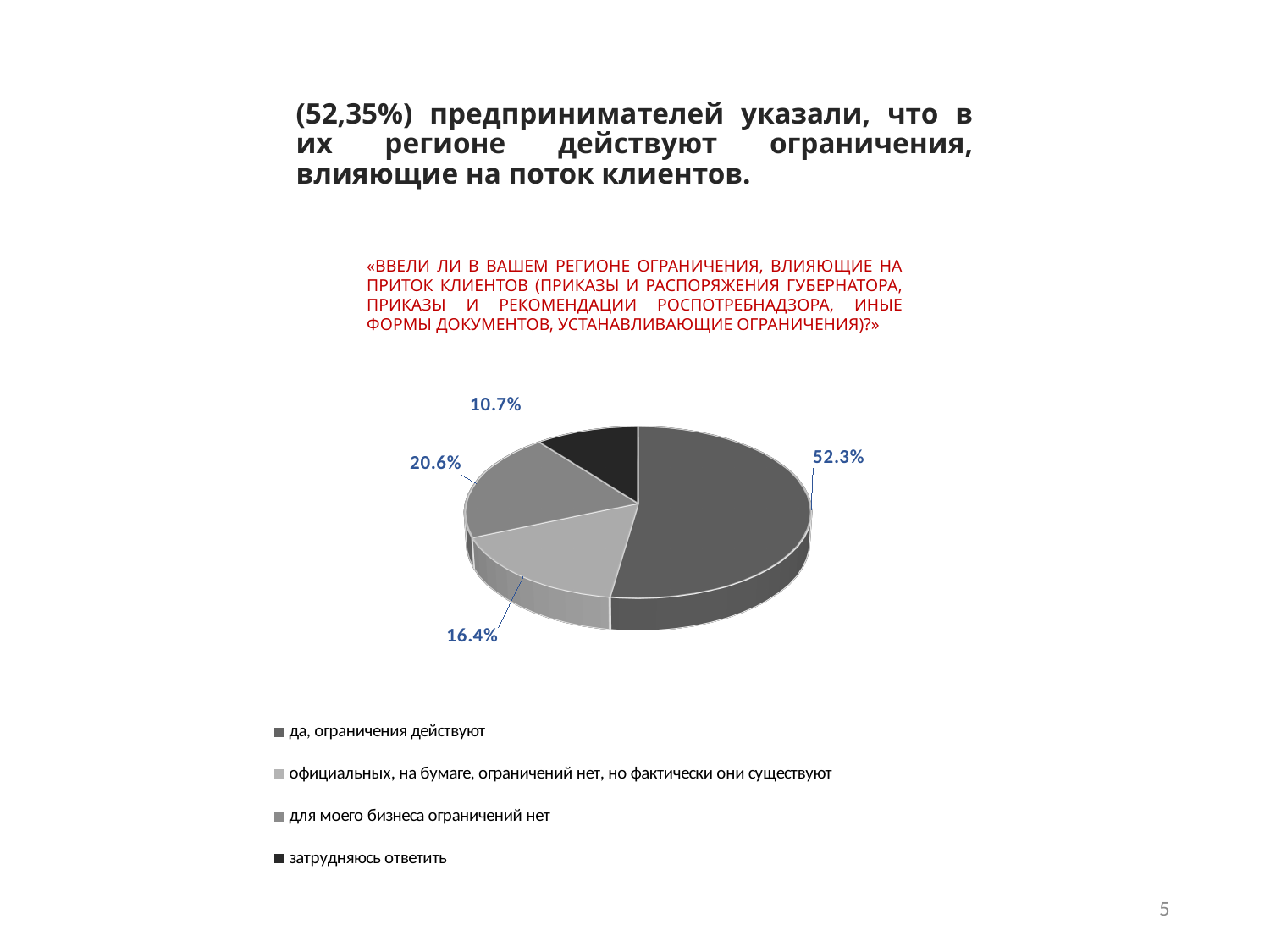
What share of respondents answered «да, ограничения действуют»? 52.3% What share of respondents answered «затрудняюсь ответить»? 10.7% Which is larger: the share for «для моего бизнеса ограничений нет» or the share for «официальных, на бумаге, ограничений нет, но фактически они существуют»? для моего бизнеса ограничений нет How many slices does the pie chart have? 4 Which answer option has the smallest slice of the pie? затрудняюсь ответить What type of chart is shown on the slide? pie chart What share of respondents answered «для моего бизнеса ограничений нет»? 20.6% What is the difference between the share for «да, ограничения действуют» and the share for «для моего бизнеса ограничений нет»? 31.7% What colour is the slice for «затрудняюсь ответить»? black How many entries does the legend list? 4 Which answer option has the largest slice of the pie? да, ограничения действуют What share of respondents answered «официальных, на бумаге, ограничений нет, но фактически они существуют»? 16.4%